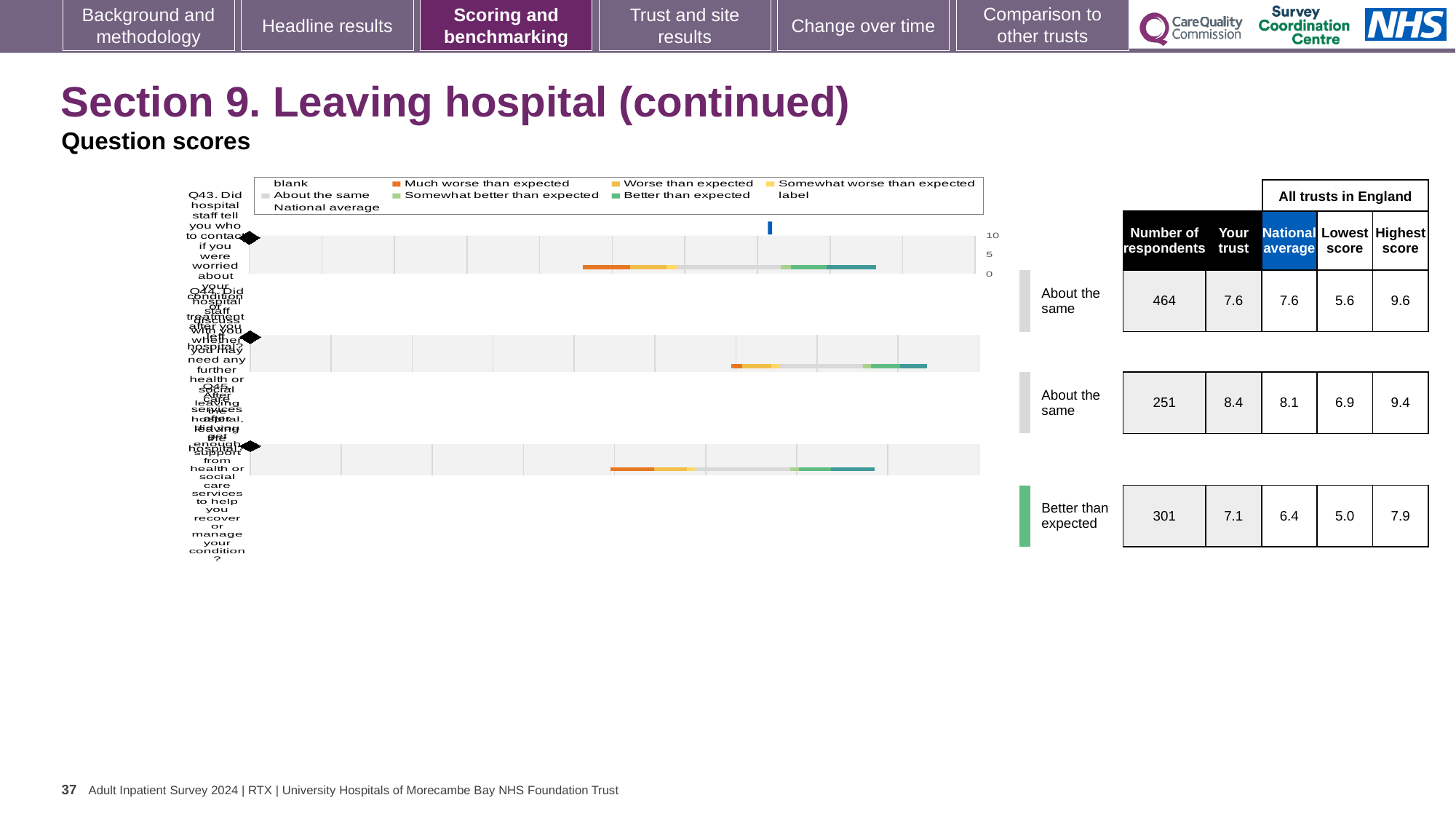
For the bottom chart (Q45), how many respondents are shown in the table? 301 Which benchmark category is the bottom chart (Q45) assigned? Better than expected How many question charts (rows) are shown on the slide? 3 For the top chart (Q43), what is the lowest score across all trusts in England? 5.6 For the middle chart (Q44), what is the national average score shown in the table? 8.1 Which benchmark category is the middle chart (Q44) assigned? About the same For the bottom chart (Q45), what is the difference between the highest score and the lowest score across all trusts in England? 2.9 For the bottom chart (Q45), which is larger: the 'Your trust' score or the national average? Your trust What kind of chart is used to show the question scores on this slide? bar chart For the top chart (Q43), what is the 'Your trust' score shown in the table? 7.6 Which of the three questions has the highest 'Your trust' score? Q44 What is the maximum value shown on the score axis of the top chart? 10